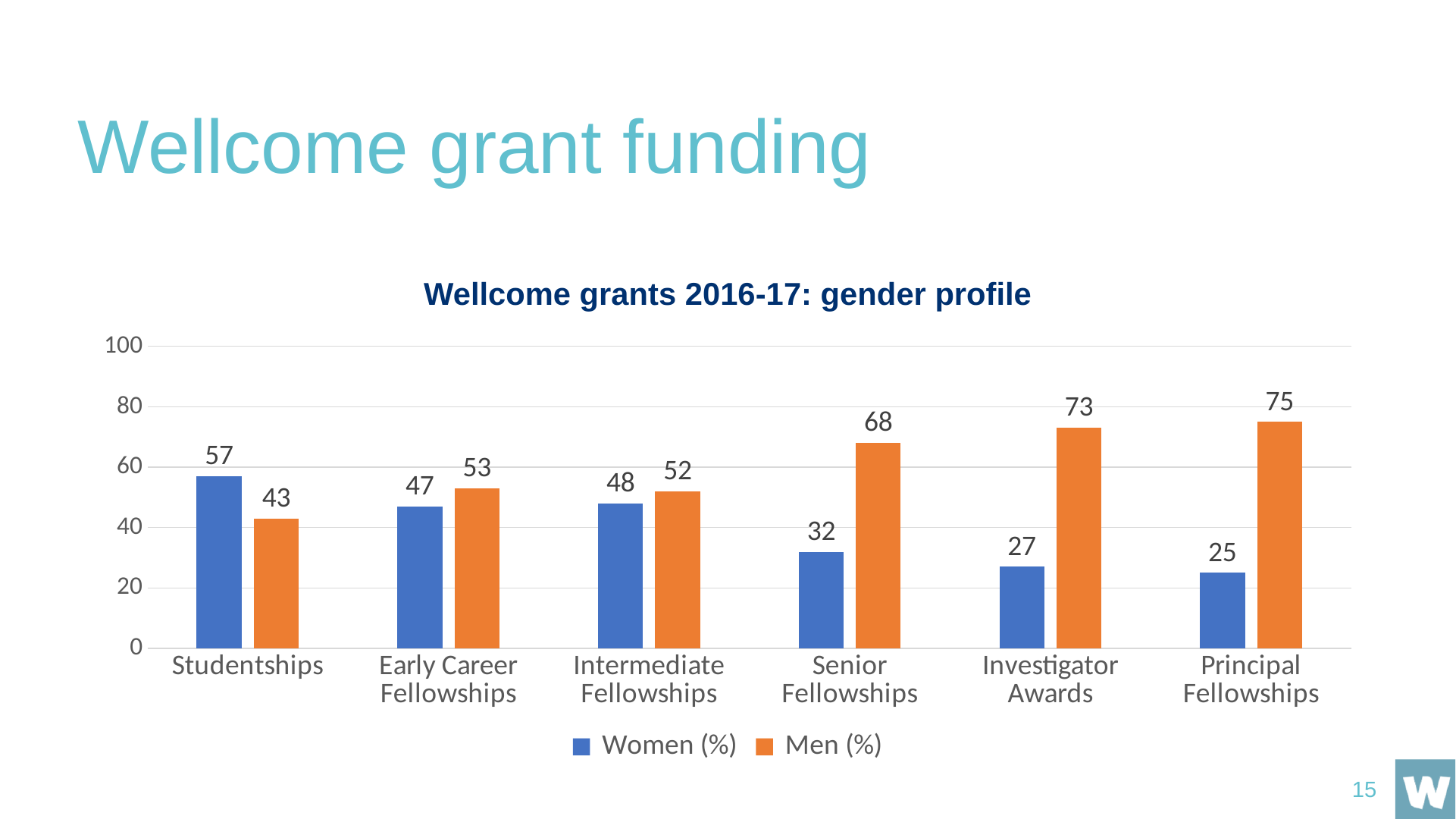
How many grant categories are shown on the x axis? 6 Which is larger for Studentships, the Women (%) value or the Men (%) value? Women (%) Is the Men (%) value for Intermediate Fellowships greater or less than 40? greater Which category has the lowest Women (%) value? Principal Fellowships What is the title of the chart? Wellcome grants 2016-17: gender profile What is the difference between the Men (%) and Women (%) values for Investigator Awards? 46 What is the Women (%) value for Studentships? 57 Which category has the highest Men (%) value? Principal Fellowships What is the Men (%) value for Senior Fellowships? 68 What kind of chart is shown on the slide? Bar chart What is the Women (%) value for Principal Fellowships? 25 How many series does the legend list? 2